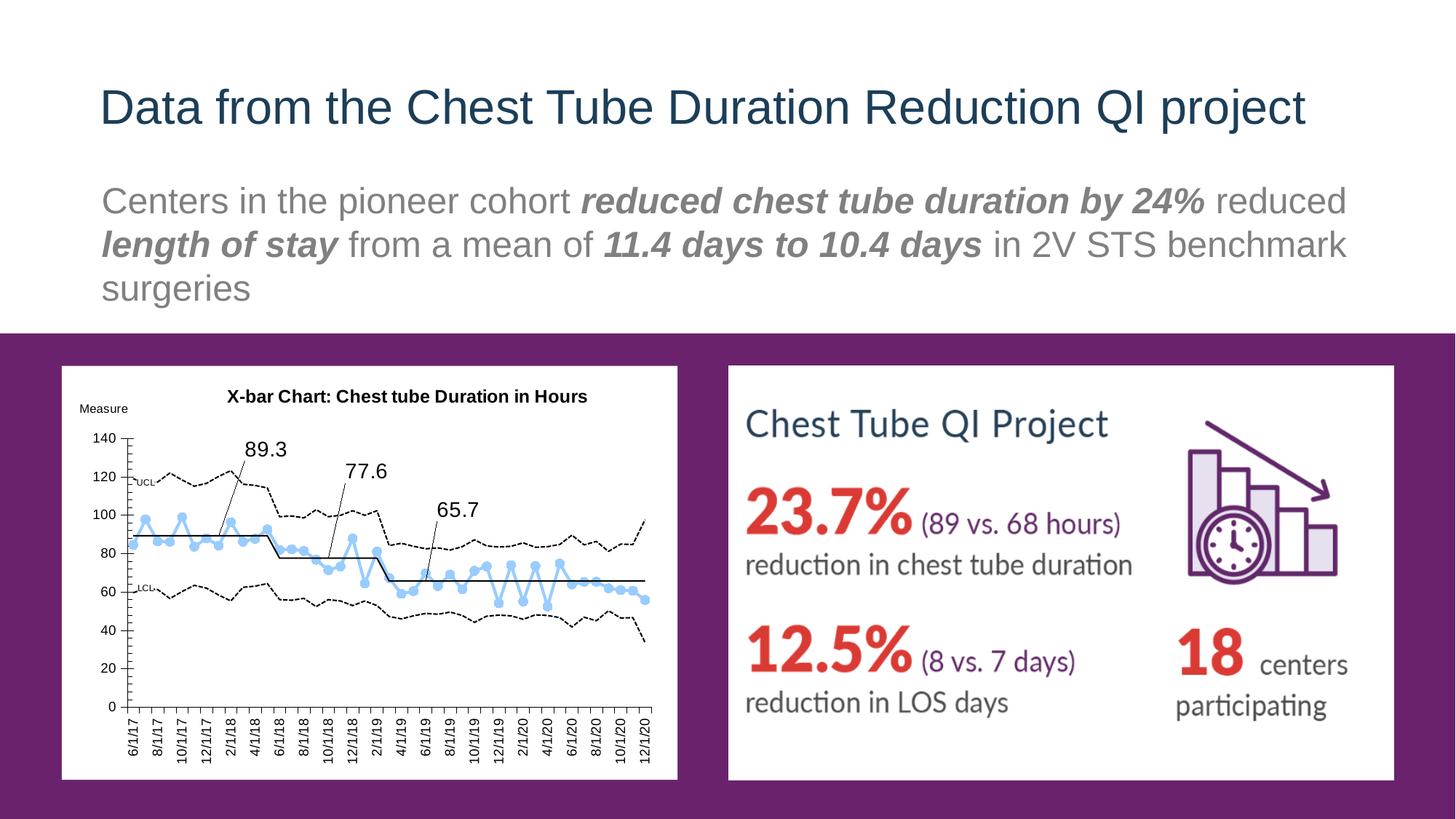
What is the labelled center-line value for the middle phase of the X-bar chart (around 2018)? 77.6 Do the chest tube duration values rise or fall over time along the x axis? fall What is the title of the chart? X-bar Chart: Chest tube Duration in Hours What kind of chart is shown on the slide? line chart Which labelled center-line value is the lowest? 65.7 Is the plotted value for 12/1/20 greater or less than 80? less What is the labelled center-line value for the first phase of the X-bar chart (starting 6/1/17)? 89.3 How many labelled center-line phases does the X-bar chart show? 3 What is the difference between the center-line values 89.3 and 77.6? 11.7 Which labelled center-line value is the highest? 89.3 What is the labelled center-line value for the final phase of the X-bar chart (from 2019 onward)? 65.7 What is the difference between the first center-line value (89.3) and the last center-line value (65.7)? 23.6